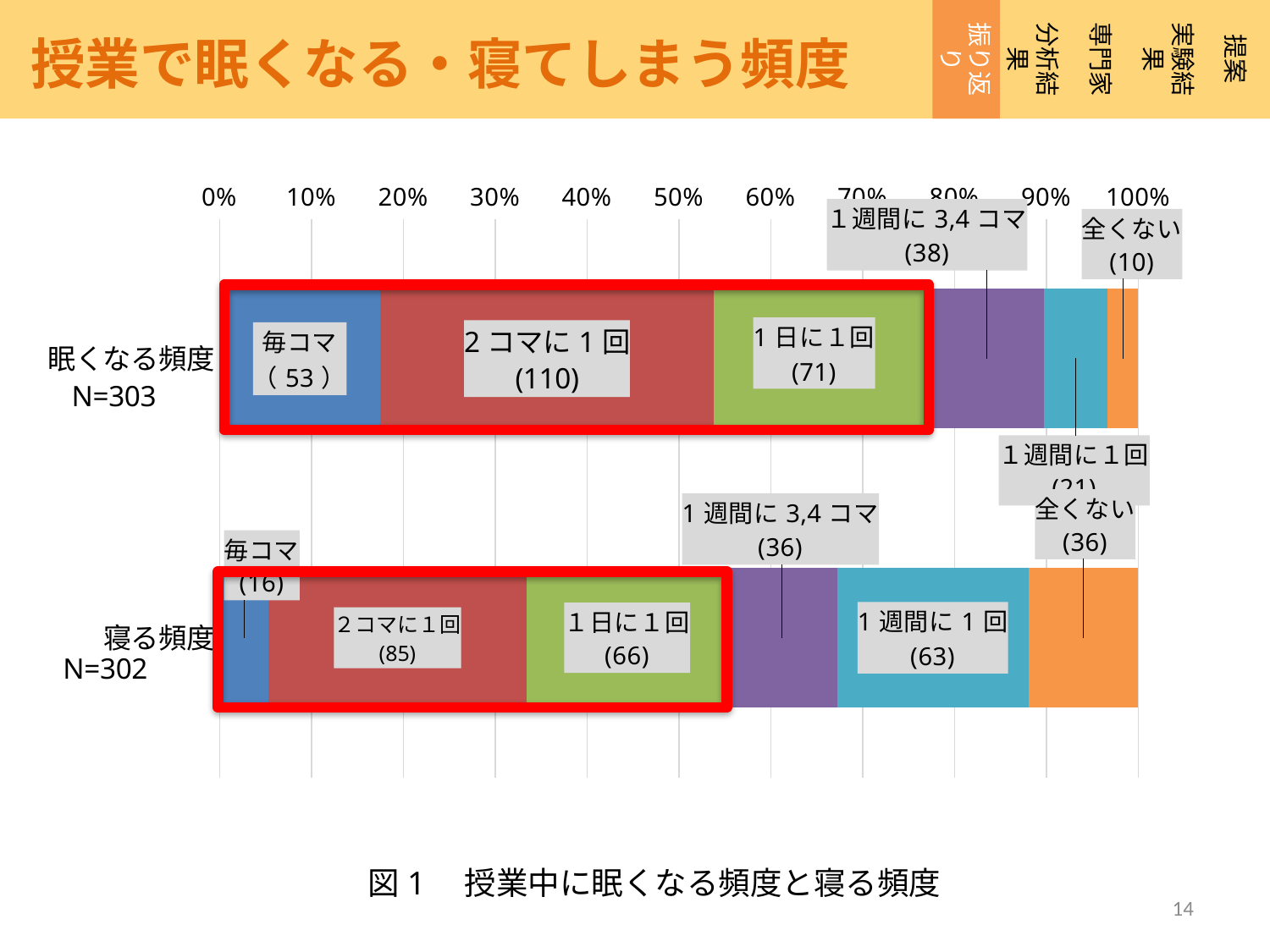
Which segment is the largest in the 寝る頻度 (N=302) bar? 2コマに1回 Which segment is the smallest in the 寝る頻度 (N=302) bar? 毎コマ Which segment is the smallest in the 眠くなる頻度 (N=303) bar? 全くない What is the difference between the 2コマに1回 values for 眠くなる頻度 and 寝る頻度? 25 In the 寝る頻度 (N=302) bar, what is the value shown for 毎コマ? 16 How many bars (categories) are plotted in the chart? 2 In the 眠くなる頻度 (N=303) bar, what is the value shown for 2コマに1回? 110 Which segment is the largest in the 眠くなる頻度 (N=303) bar? 2コマに1回 What kind of chart is shown on the slide? Stacked bar chart In the 眠くなる頻度 (N=303) bar, what is the value shown for 全くない? 10 In the 寝る頻度 (N=302) bar, what is the value shown for 1週間に1回? 63 Which bar has the larger value for 1日に1回, 眠くなる頻度 or 寝る頻度? 眠くなる頻度